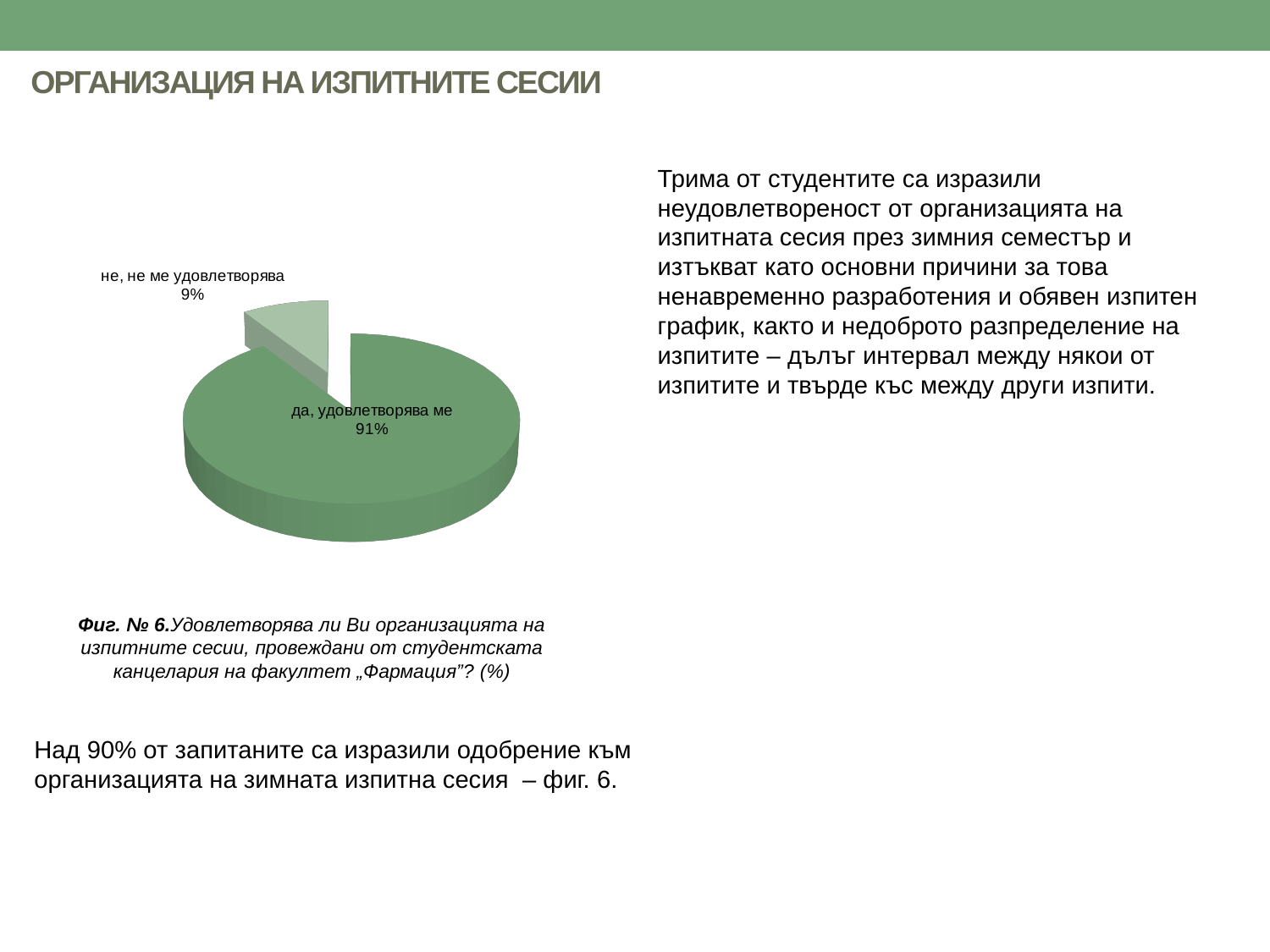
What is the difference in percentage points between "да, удовлетворява ме" and "не, не ме удовлетворява"? 82 What is the figure number given in the caption of the chart? Фиг. № 6 What percentage is shown for "да, удовлетворява ме"? 91% What share of the pie does the "не, не ме удовлетворява" slice represent? 9% What percentage is shown for "не, не ме удовлетворява"? 9% What kind of chart is shown on the slide? pie chart Which is larger: the share for "да, удовлетворява ме" or for "не, не ме удовлетворява"? да, удовлетворява ме Is the "не, не ме удовлетворява" slice pulled out (exploded) from the rest of the pie? yes How many slices does the pie chart have? 2 Which slice of the pie chart is the smallest? не, не ме удовлетворява Which slice of the pie chart is the largest? да, удовлетворява ме